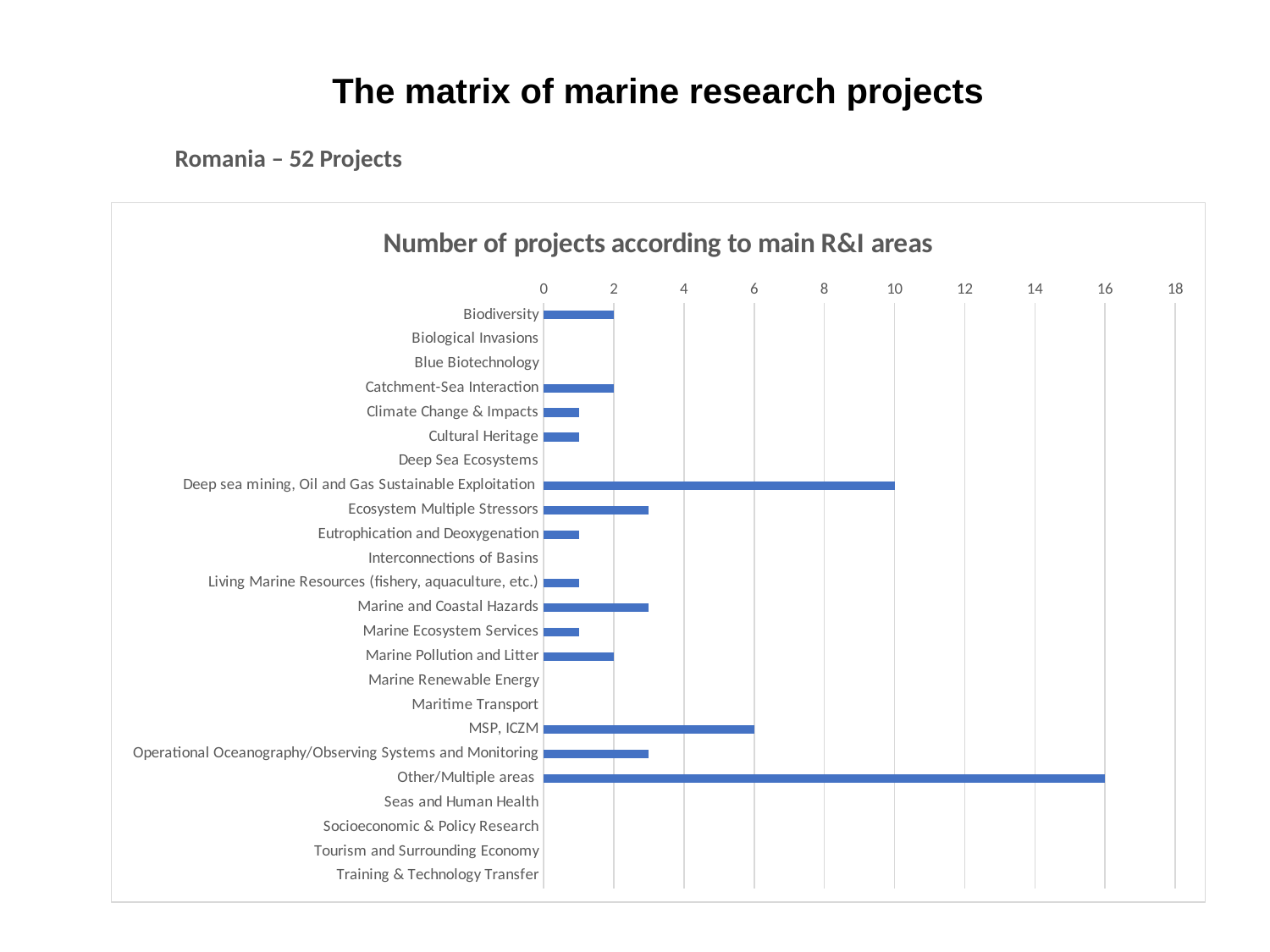
What is the title of the chart? Number of projects according to main R&I areas What is the difference in the number of projects between Other/Multiple areas and Deep sea mining, Oil and Gas Sustainable Exploitation? 6 How many projects are in the Deep sea mining, Oil and Gas Sustainable Exploitation category? 10 Which R&I area has the highest number of projects? Other/Multiple areas Is the value for Climate Change & Impacts greater or less than 2? less How many projects are in the Other/Multiple areas category? 16 Which has more projects: Deep sea mining, Oil and Gas Sustainable Exploitation or MSP, ICZM? Deep sea mining, Oil and Gas Sustainable Exploitation How many R&I area categories are listed on the chart's axis? 24 What type of chart is shown on the slide? bar chart How many projects are in the MSP, ICZM category? 6 How many projects are in the Biodiversity category? 2 Is the value for Ecosystem Multiple Stressors greater or less than 2? greater